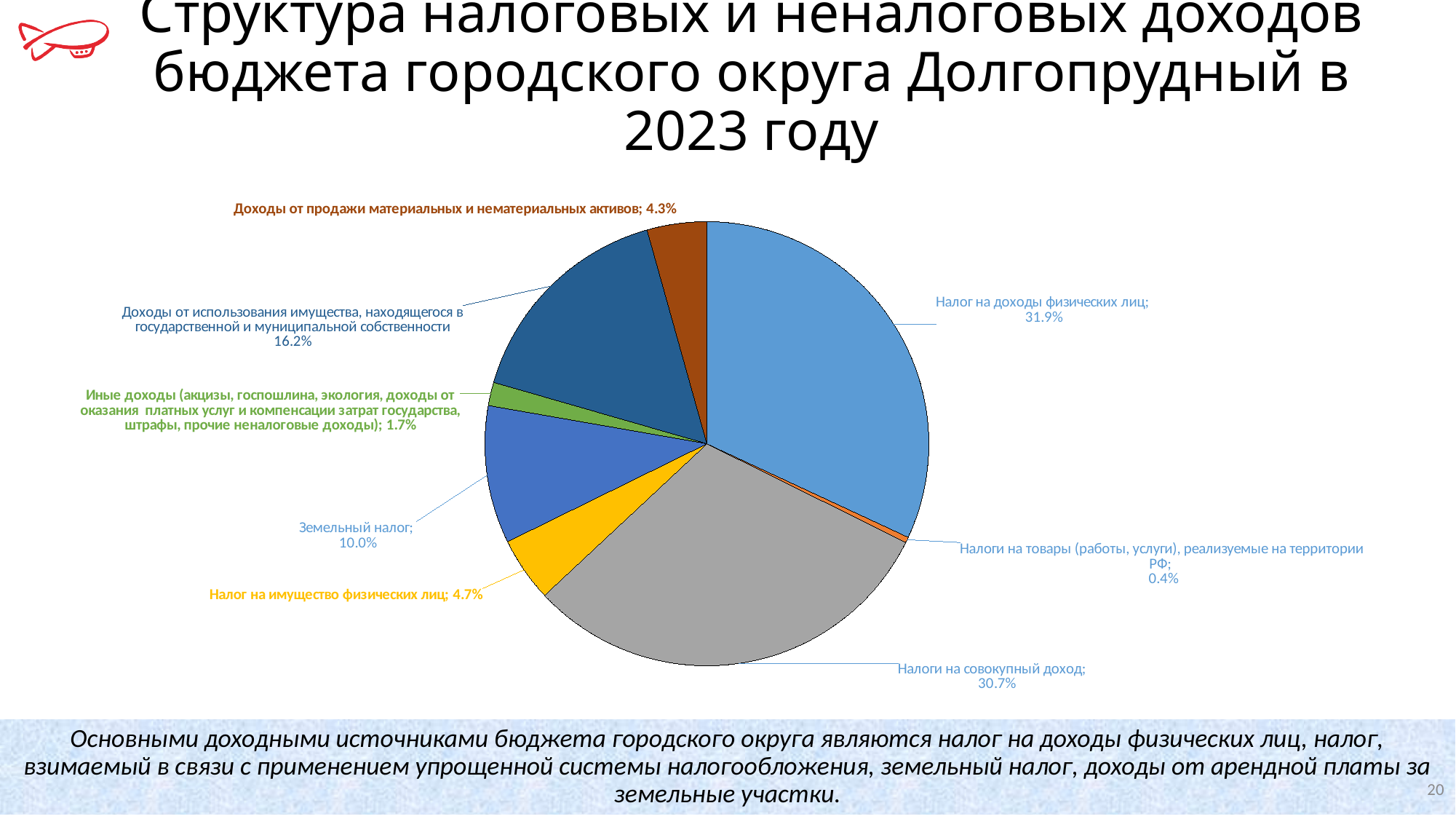
What is the value shown for "Земельный налог"? 10.0% How many slices does the pie chart have? 8 Which category has the smallest share of the pie? Налоги на товары (работы, услуги), реализуемые на территории РФ What is the value shown for "Налоги на совокупный доход"? 30.7% What is the value shown for "Доходы от использования имущества, находящегося в государственной и муниципальной собственности"? 16.2% What is the difference between the shares of "Доходы от использования имущества, находящегося в государственной и муниципальной собственности" and "Земельный налог"? 6.2% What share of the pie does "Налог на доходы физических лиц" have? 31.9% Which category has the largest share of the pie? Налог на доходы физических лиц What is the difference between the shares of "Налог на доходы физических лиц" and "Налоги на совокупный доход"? 1.2% Which is larger: "Земельный налог" or "Налог на имущество физических лиц"? Земельный налог What is the value shown for "Доходы от продажи материальных и нематериальных активов"? 4.3% What kind of chart is shown on the slide? Pie chart